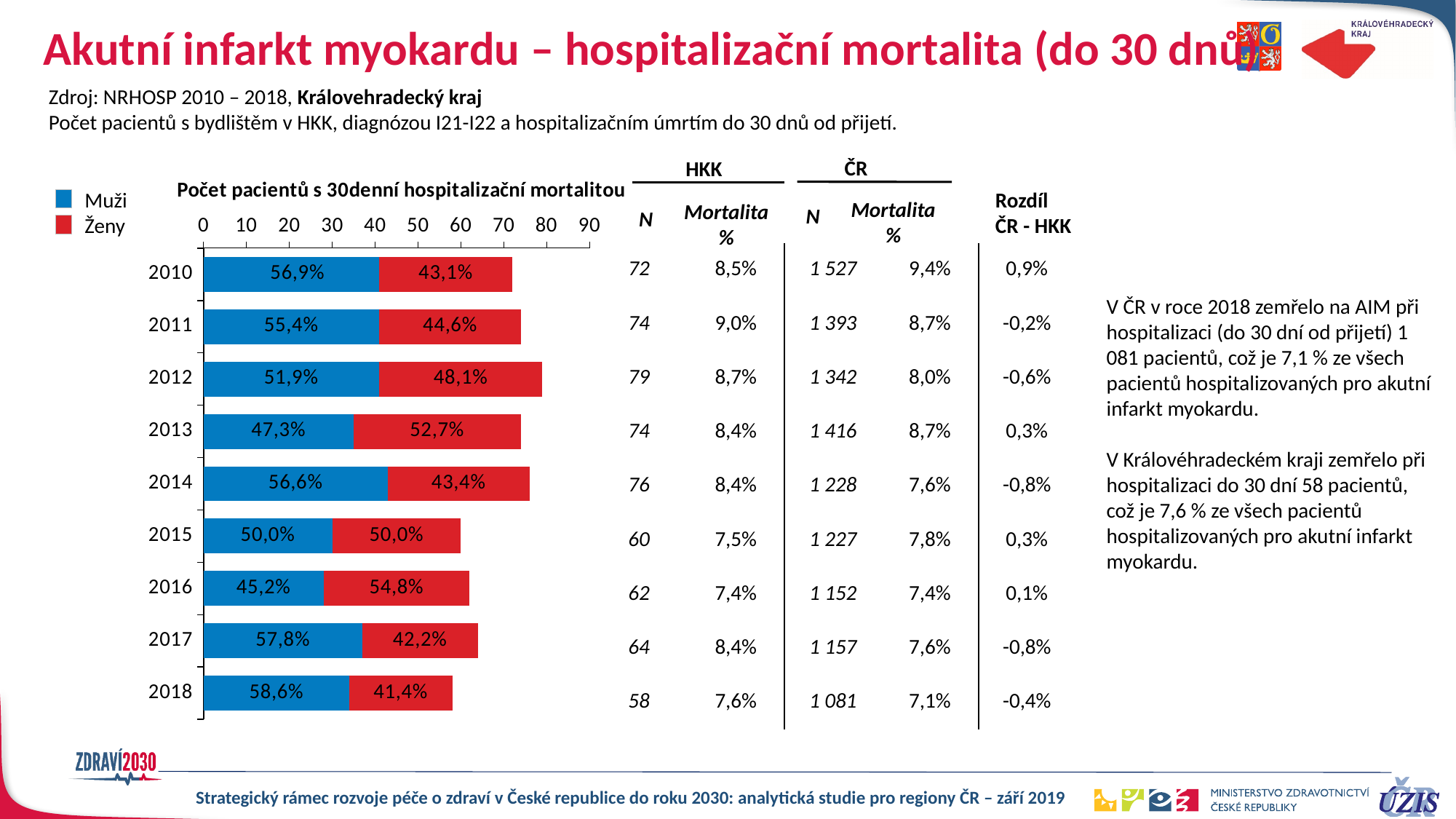
What is the Ženy share shown for 2010 in the chart? 43,1% What is the Muži share shown for 2015 in the chart? 50,0% What is the Ženy share shown for 2013 in the chart? 52,7% What kind of chart is shown on the slide? bar chart How many series does the legend of the chart list? 2 What is the difference between the Muži and Ženy shares for 2017 in the chart? 15,6% How many years are shown on the chart's vertical axis? 9 Is the total bar length for 2016 greater or less than 70? less In 2013, which is larger in the chart, the Muži share or the Ženy share? Ženy What is the Muži share shown for 2018 in the chart? 58,6% Is the total bar length for 2012 greater or less than 70? greater Which colour represents Muži in the chart? blue